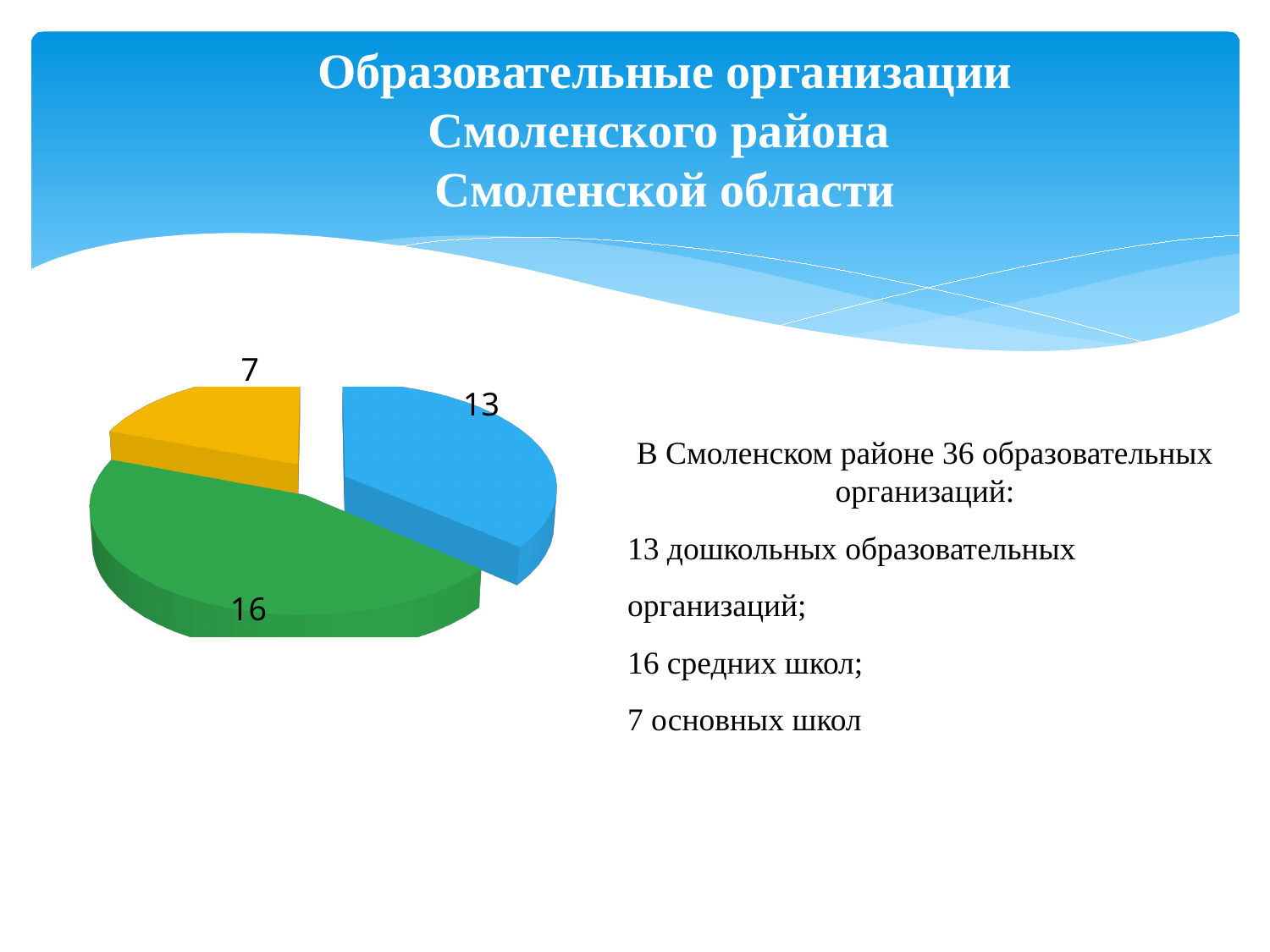
What kind of chart is shown on the slide? pie chart What is the total of all slices in the pie chart? 36 How many slices does the pie chart have? 3 What is the value shown on the blue slice of the pie chart? 13 What is the value shown on the green slice of the pie chart? 16 What is the difference between the largest slice (16) and the smallest slice (7) of the pie chart? 9 What colour is the largest slice of the pie chart? green Which slice is larger in the pie chart, the blue one or the yellow one? the blue one What is the difference between the green slice (16) and the blue slice (13) of the pie chart? 3 What is the value of the largest slice of the pie chart? 16 What is the value shown on the yellow slice of the pie chart? 7 What is the value of the smallest slice of the pie chart? 7